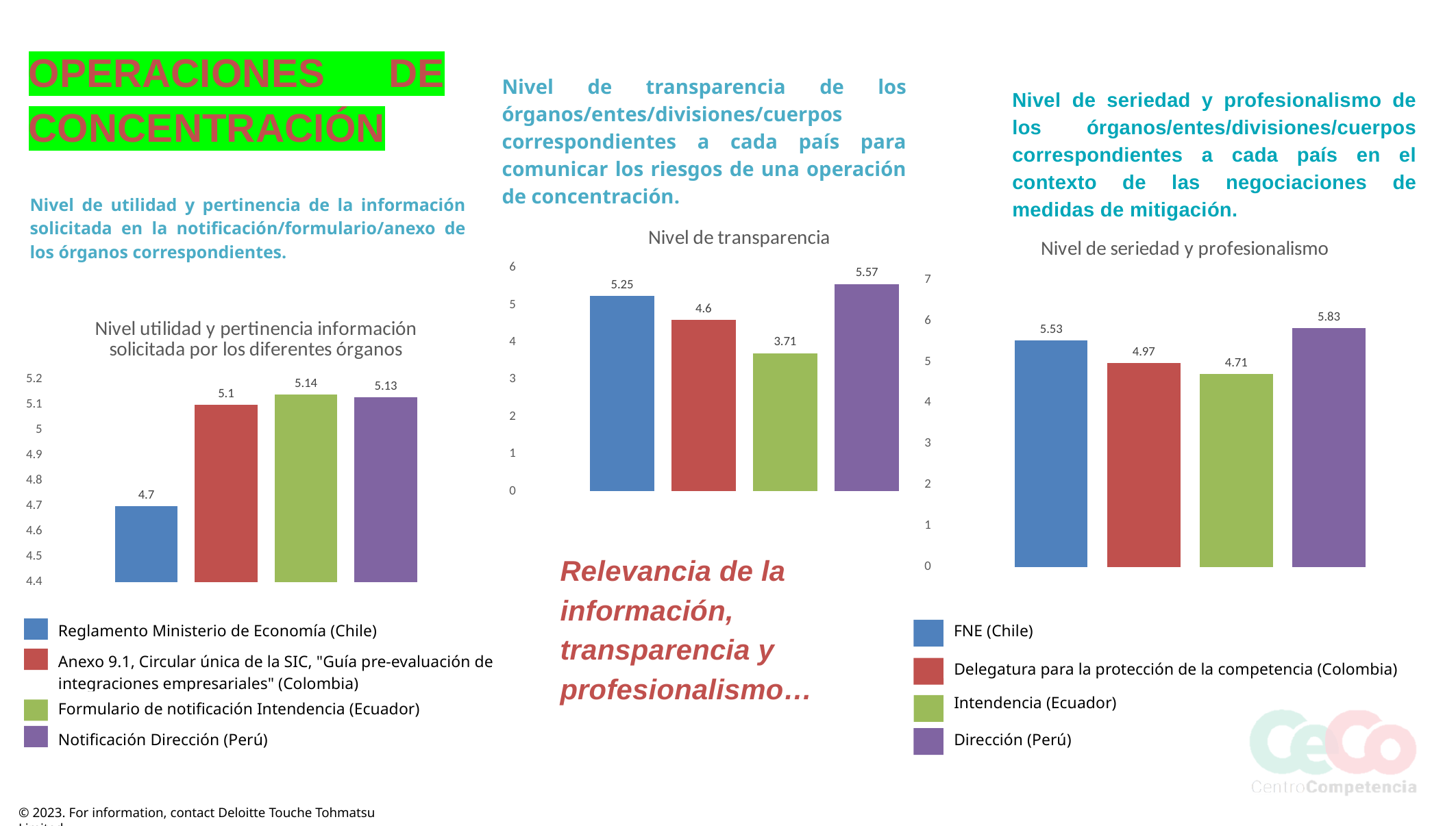
In the 'Nivel utilidad y pertinencia información solicitada por los diferentes órganos' chart, what is the value for Reglamento Ministerio de Economía (Chile)? 4.7 In the 'Nivel de seriedad y profesionalismo' chart, what is the value for Delegatura para la protección de la competencia (Colombia)? 4.97 In the 'Nivel de seriedad y profesionalismo' chart, which is larger: the value for FNE (Chile) or the value for Intendencia (Ecuador)? FNE (Chile) What type of chart is the 'Nivel de seriedad y profesionalismo' chart? Bar chart In the 'Nivel utilidad y pertinencia información solicitada por los diferentes órganos' chart, which category has the highest value? Formulario de notificación Intendencia (Ecuador) In the 'Nivel de seriedad y profesionalismo' chart, which category has the highest value? Dirección (Perú) In the 'Nivel de transparencia' chart, what is the difference between the blue (first) bar and the red (second) bar? 0.65 In the 'Nivel de transparencia' chart, what is the value of the green (third) bar? 3.71 In the 'Nivel utilidad y pertinencia información solicitada por los diferentes órganos' chart, what is the difference between the value for Notificación Dirección (Perú) and the value for Reglamento Ministerio de Economía (Chile)? 0.43 In the 'Nivel de transparencia' chart, how many bars are plotted? 4 In the 'Nivel utilidad y pertinencia información solicitada por los diferentes órganos' chart, which category has the lowest value? Reglamento Ministerio de Economía (Chile) In the 'Nivel de transparencia' chart, what is the value of the purple (fourth) bar? 5.57